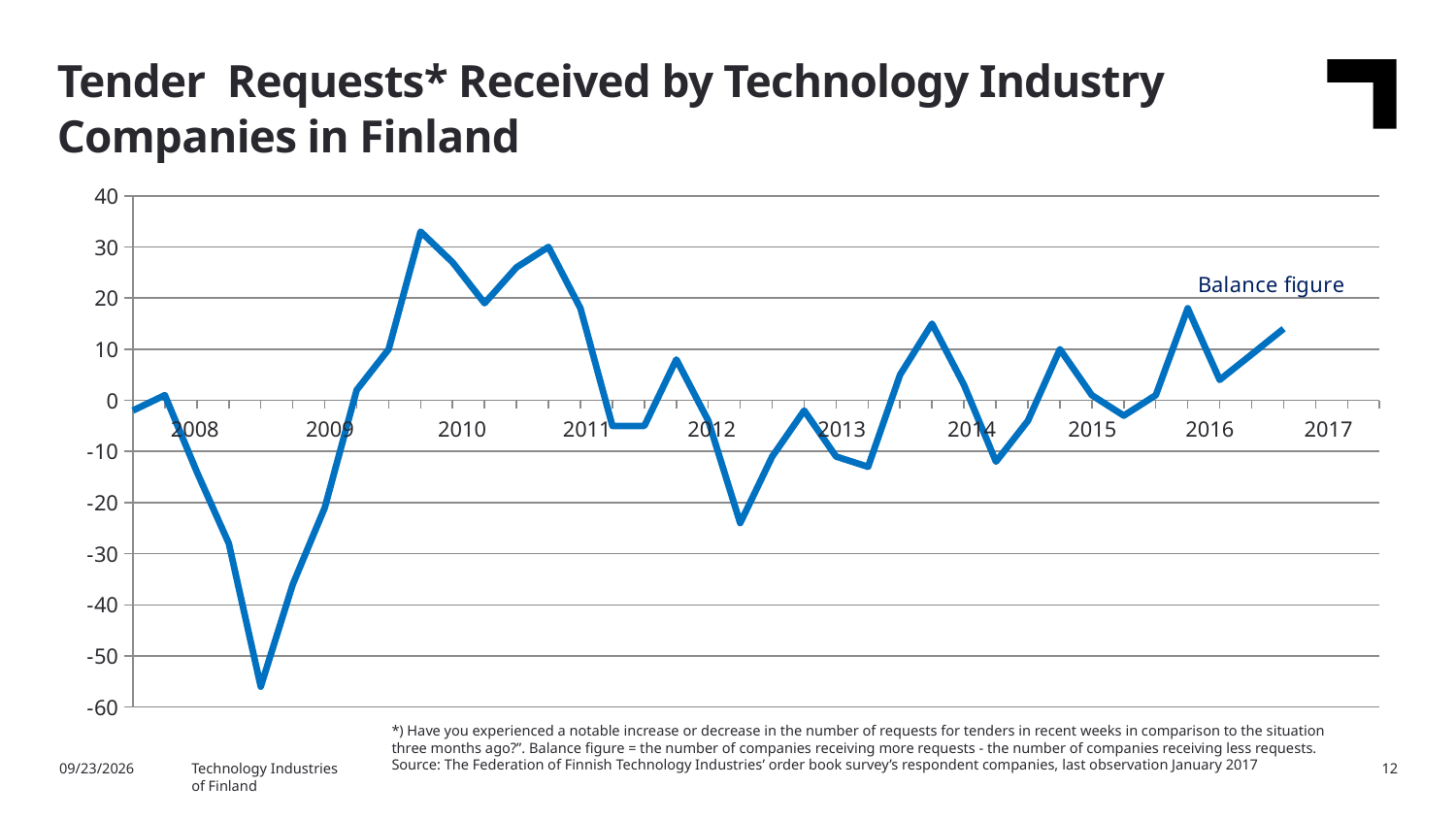
What is the name of the series shown in the chart's legend? Balance figure What is the title of the chart on the slide? Tender Requests* Received by Technology Industry Companies in Finland How many year labels are shown on the x axis? 10 Is the last plotted value (January 2017) greater or less than 10? greater How many series does the chart's legend list? 1 Between the start of 2008 and the start of 2009, do the values rise or fall? fall Is the highest value on the chart greater or less than 30? greater Between the start of 2009 and the peak in 2010, do the values rise or fall? rise Is the lowest value on the chart greater or less than -50? less What kind of chart is shown on the slide? line chart